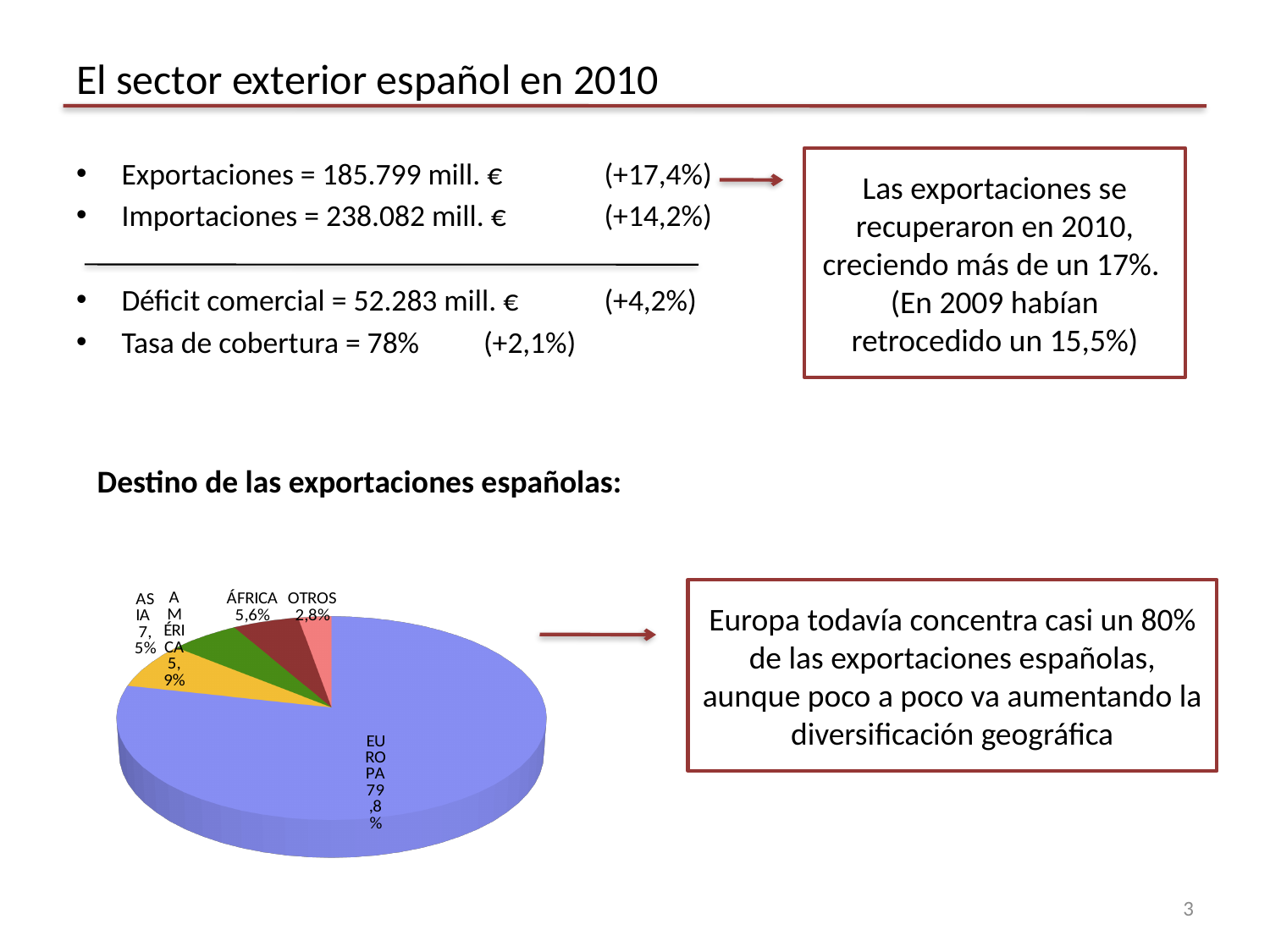
Which slice is larger in the pie chart, ASIA or AMÉRICA? ASIA Which destination has the largest slice in the pie chart? EUROPA How many slices does the pie chart have? 5 What kind of chart is shown on the slide? pie chart What colour is the EUROPA slice in the pie chart? blue What share of Spanish exports goes to EUROPA according to the pie chart? 79,8% Which destination has the smallest slice in the pie chart? OTROS What is the difference in percentage points between the EUROPA slice and the ASIA slice? 72,3 What share of Spanish exports goes to ÁFRICA according to the pie chart? 5,6% What share of Spanish exports goes to OTROS according to the pie chart? 2,8% What share of Spanish exports goes to AMÉRICA according to the pie chart? 5,9% What share of Spanish exports goes to ASIA according to the pie chart? 7,5%